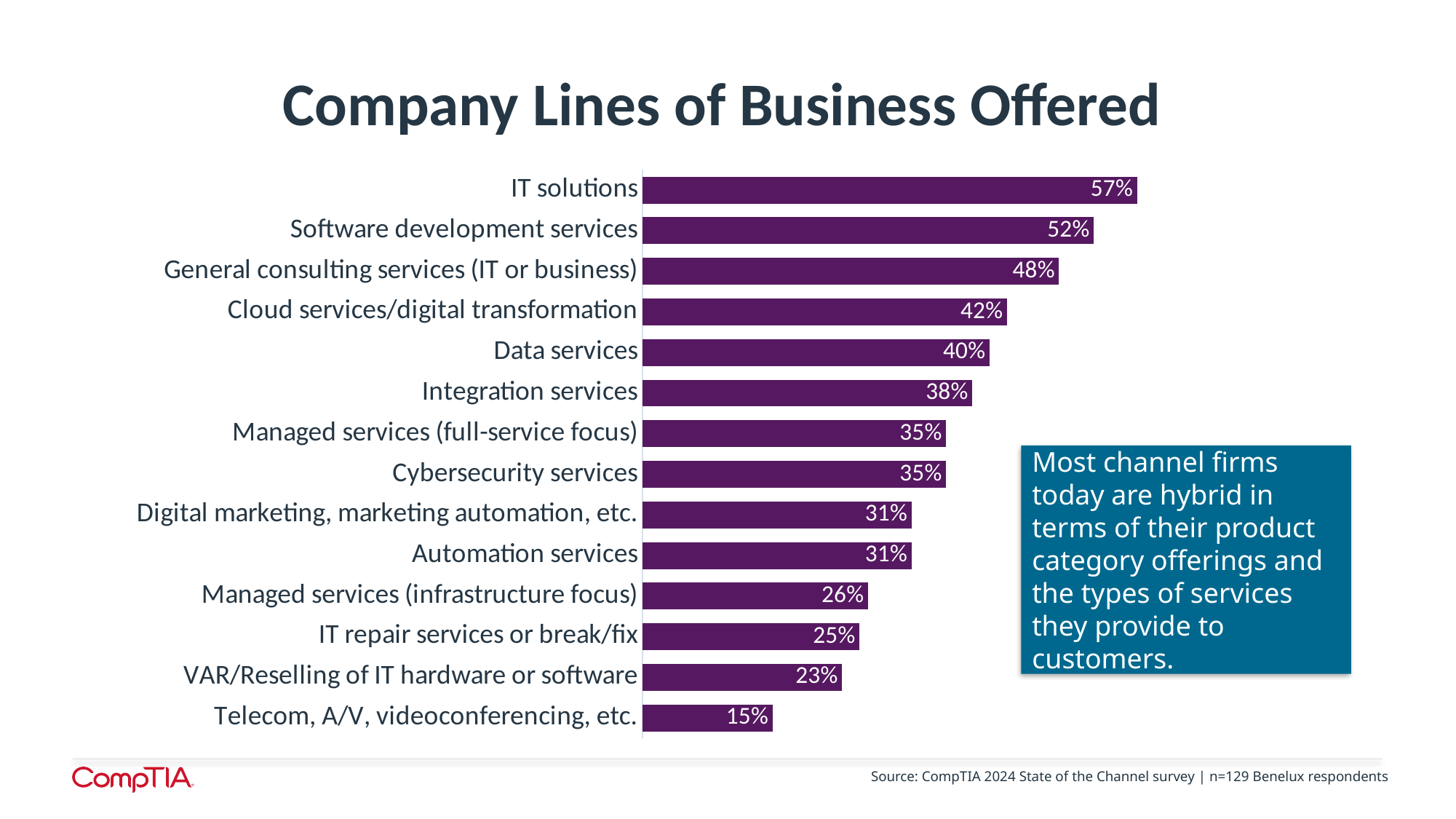
Which is larger: General consulting services (IT or business) or Managed services (infrastructure focus)? General consulting services (IT or business) Which line of business has the highest percentage? IT solutions What is the difference between Integration services and Telecom, A/V, videoconferencing, etc.? 23% Which is larger: IT repair services or break/fix or Automation services? Automation services What is the title of the chart? Company Lines of Business Offered What is the difference between Software development services and Data services? 12% What percentage of respondents offer IT solutions? 57% What type of chart is shown on the slide? Bar chart How many lines of business are shown in the chart? 14 Which line of business has the lowest percentage? Telecom, A/V, videoconferencing, etc. What is the value for Cloud services/digital transformation? 42% What percentage is shown for VAR/Reselling of IT hardware or software? 23%